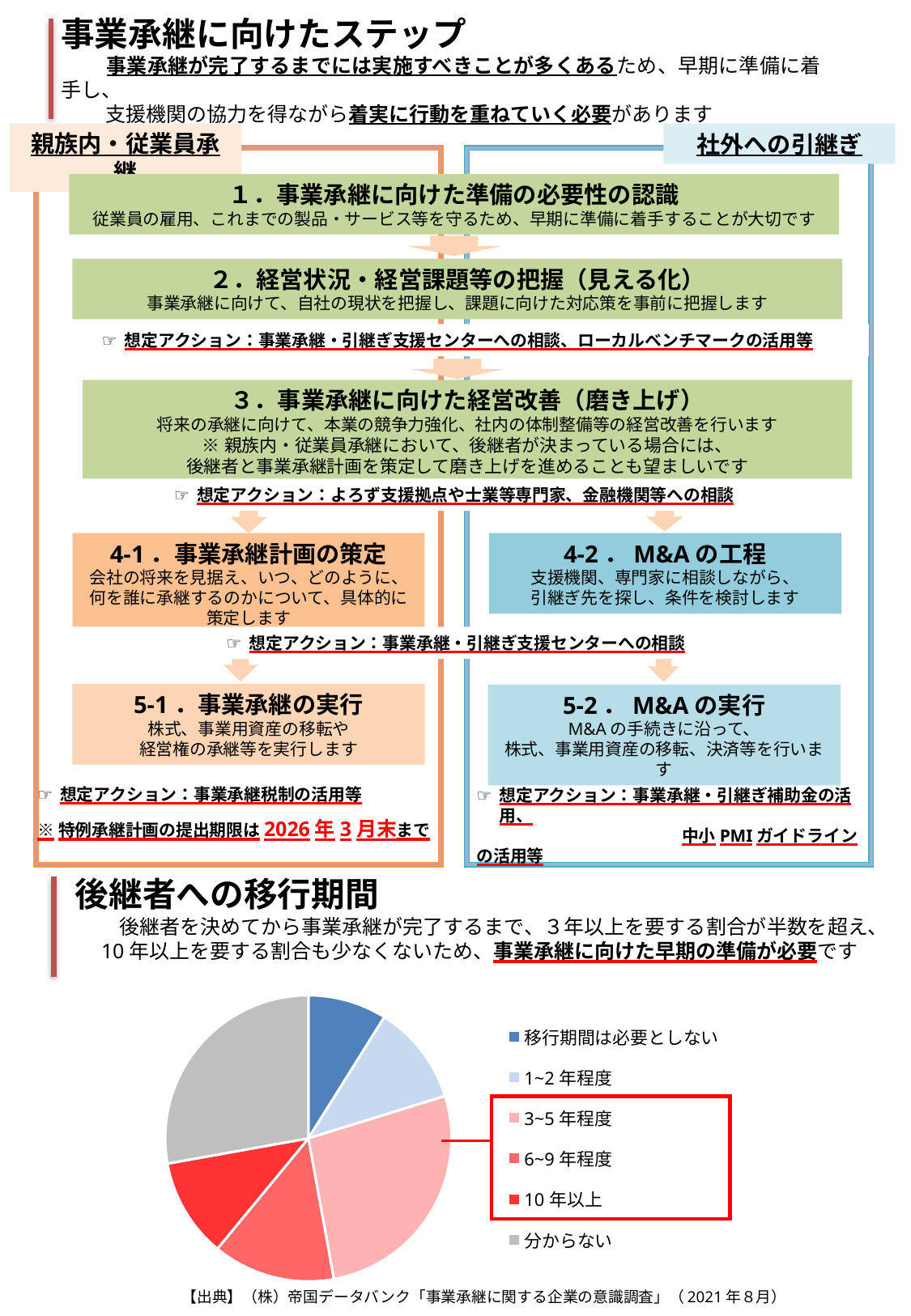
In the pie chart, which slice is larger: 3~5年程度 or 1~2年程度? 3~5年程度 What colour is the 分からない slice in the pie chart? grey How many categories does the pie chart's legend list? 6 In the pie chart, which slice is larger: 3~5年程度 or 6~9年程度? 3~5年程度 In the pie chart, which slice is larger: 分からない or 移行期間は必要としない? 分からない Which category has the smallest slice in the pie chart? 移行期間は必要としない What kind of chart is shown under 後継者への移行期間? pie chart Which legend entries of the pie chart are enclosed in the red box? 3~5年程度, 6~9年程度, 10年以上